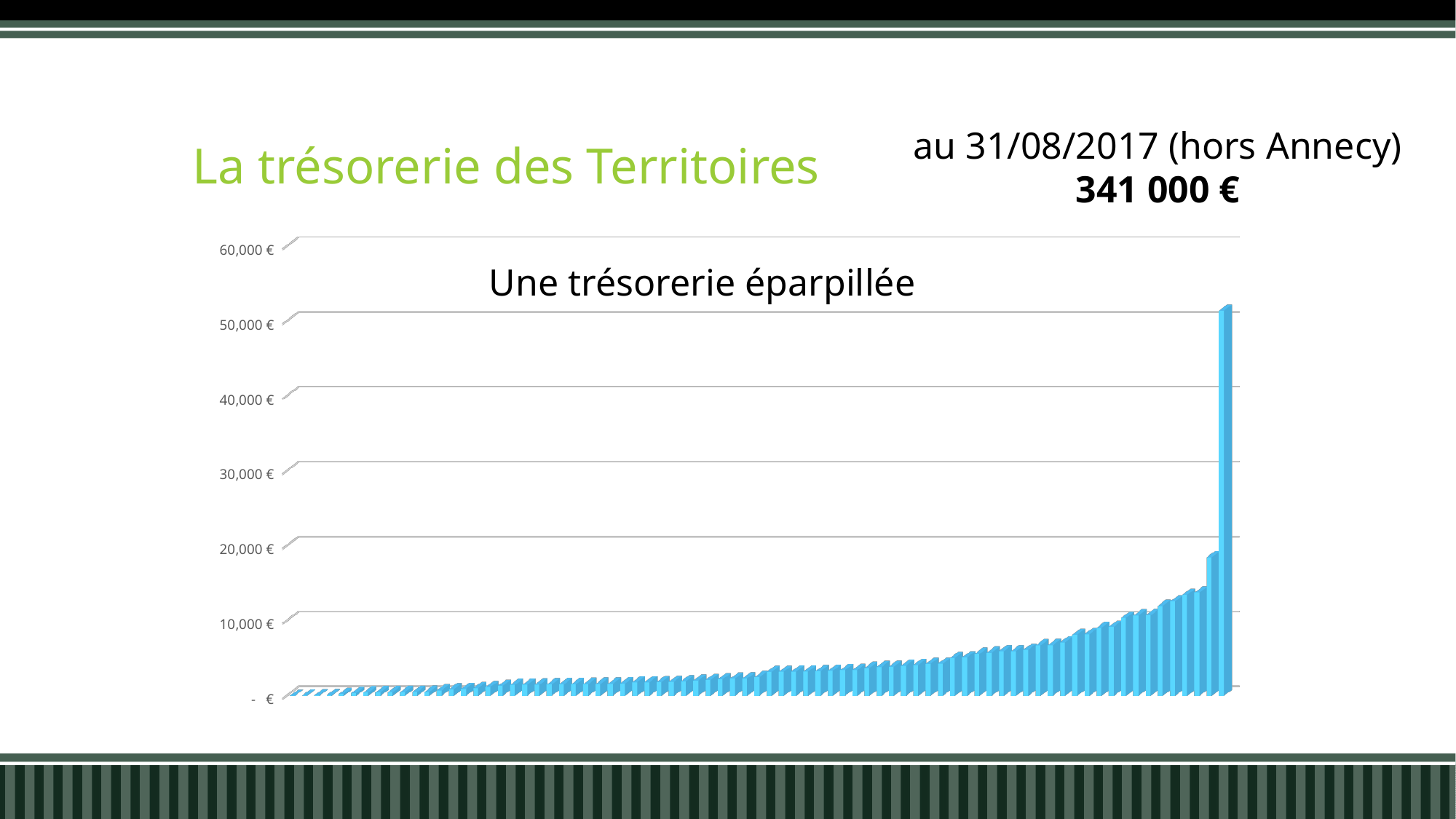
Is the value of the shortest bar (leftmost) greater or less than 10,000 €? less Which bar is the highest: the rightmost bar or the leftmost bar? the rightmost bar Do the bar values rise or fall from left to right along the x axis? rise What is the title of the chart? Une trésorerie éparpillée Is the value of the tallest bar greater or less than 40,000 €? greater What kind of chart is shown on the slide? bar chart Is the value of the second-tallest bar greater or less than 30,000 €? less What is the highest value labelled on the chart's vertical axis? 60,000 €